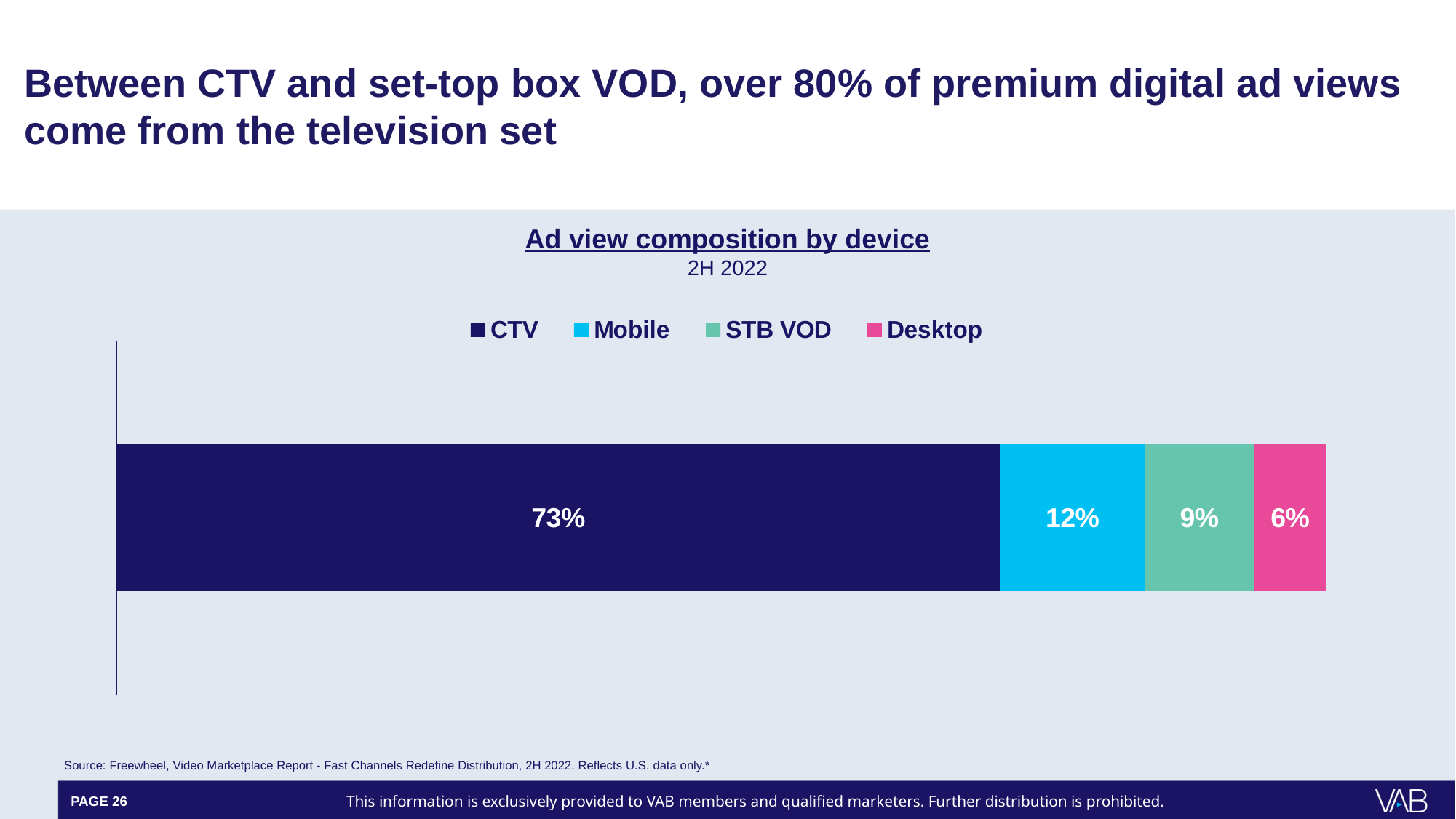
What is the difference between the CTV share and the Mobile share? 61 percentage points How many series does the legend list? 4 What is the combined share of CTV and STB VOD? 82% Which has a larger share, Mobile or STB VOD? Mobile What kind of chart is shown? Stacked bar chart What is the title of the chart? Ad view composition by device What share of ad views does STB VOD account for? 9% What share of ad views does CTV account for? 73% Which device has the smallest share of ad views? Desktop What share of ad views does Desktop account for? 6% What share of ad views does Mobile account for? 12% Which device has the largest share of ad views? CTV